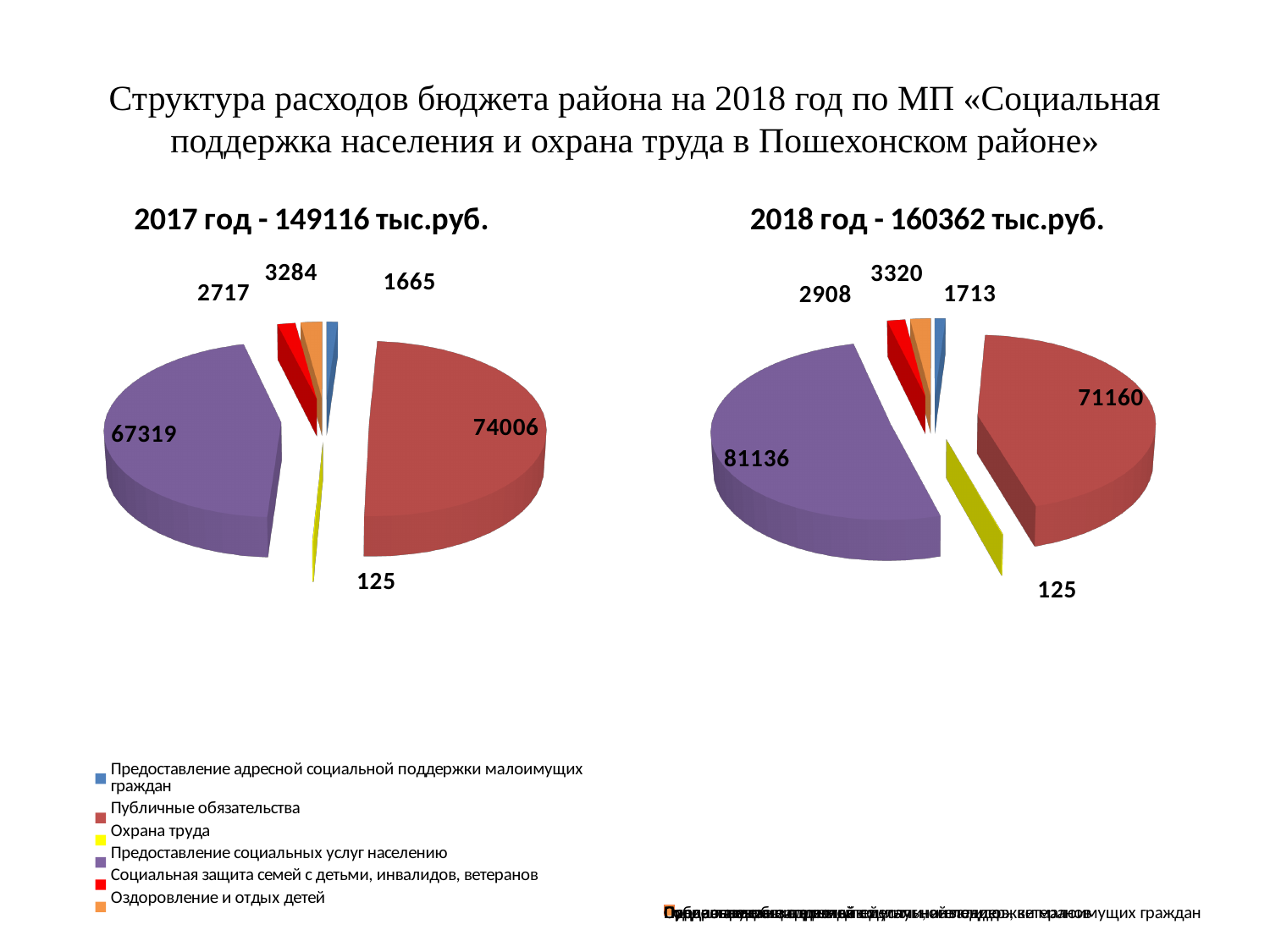
In the 2017 chart, which is larger: Публичные обязательства or Предоставление социальных услуг населению? Публичные обязательства What kind of chart is used on this slide for the 2017 and 2018 data? Pie chart In the 2018 chart, which category has the smallest value? Охрана труда How many slices does the 2018 pie chart have? 6 In the 2018 chart, what is the difference between Предоставление социальных услуг населению and Публичные обязательства? 9976 In the 2018 chart, what is the value for Предоставление социальных услуг населению? 81136 In the 2018 chart, what is the value for Охрана труда? 125 In the 2017 chart, what is the value for Предоставление адресной социальной поддержки малоимущих граждан? 1665 In the 2017 chart, what is the value for Публичные обязательства? 74006 In the 2018 chart, which category has the largest value? Предоставление социальных услуг населению In the 2017 chart, which category has the largest value? Публичные обязательства What total amount is given in the title of the 2018 chart? 160362 тыс.руб.